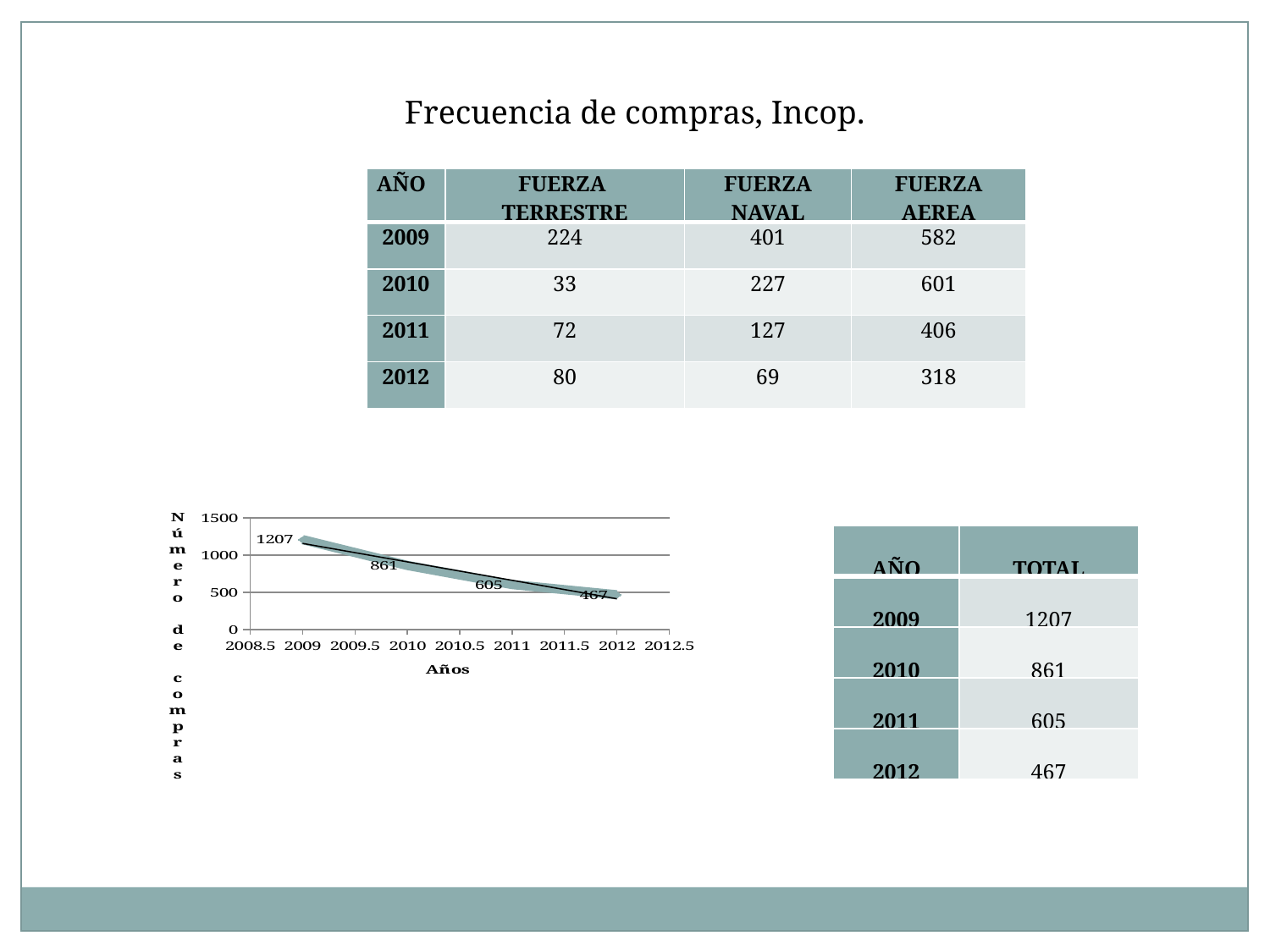
Which is larger in the chart, the value for 2010 or the value for 2011? 2010 What is the value plotted for 2010 in the chart? 861 What is the difference between the values for 2009 and 2012 in the chart? 740 What is the title of the x axis of the chart? Años What is the value plotted for 2012 in the chart? 467 Which year has the highest value in the chart? 2009 What is the value plotted for 2009 in the chart? 1207 Which year has the lowest value in the chart? 2012 What is the difference between the values for 2010 and 2011 in the chart? 256 Do the values in the chart rise or fall from 2009 to 2012? fall How many data points are plotted in the chart? 4 What is the value plotted for 2011 in the chart? 605